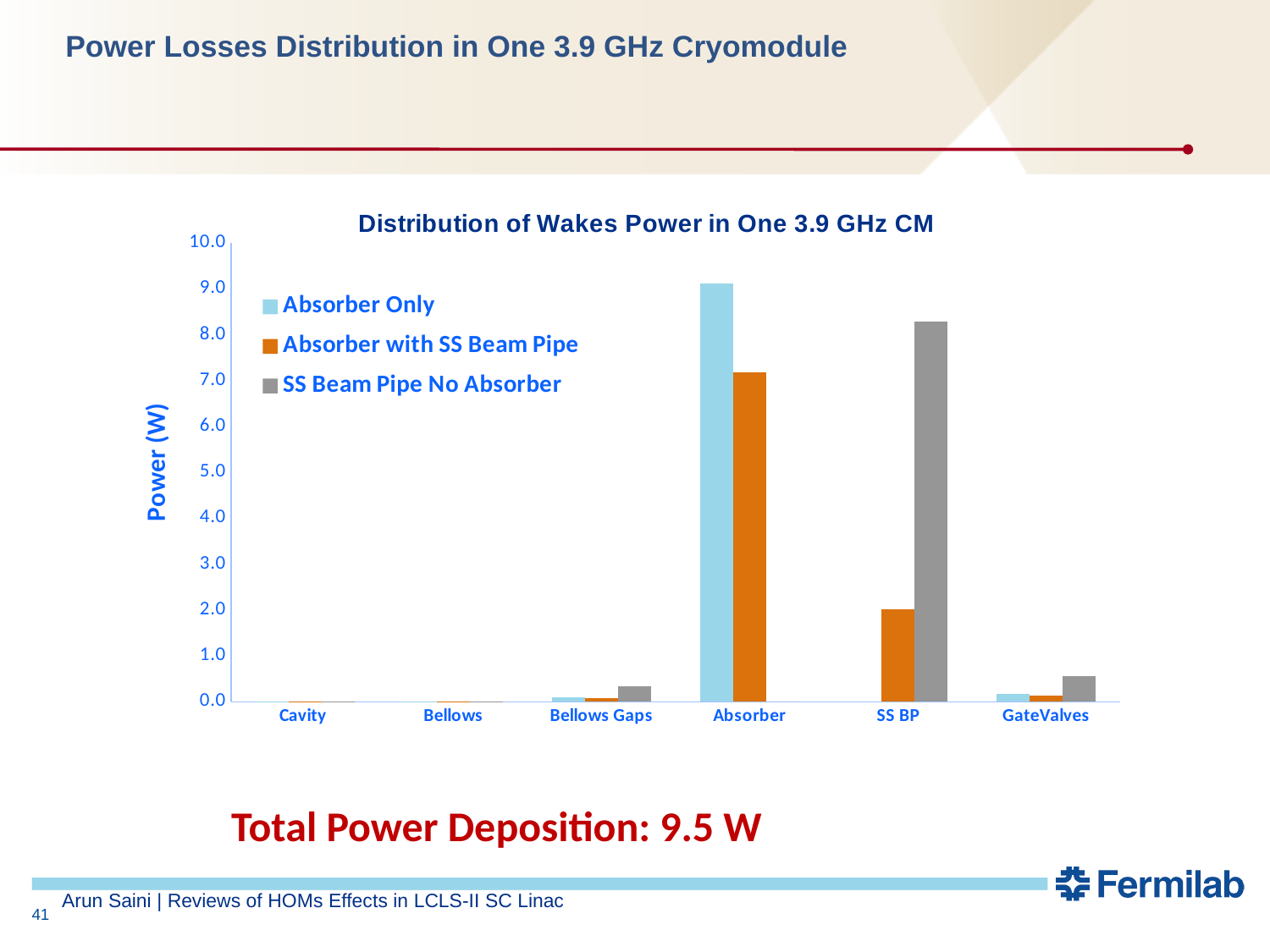
Is the Absorber with SS Beam Pipe value for Absorber greater or less than 6.0? greater Is the Absorber Only value for Absorber greater or less than 8.0? greater What is the label of the y axis? Power (W) At the Absorber category, which series has the larger value: Absorber Only or Absorber with SS Beam Pipe? Absorber Only What is the title of the chart? Distribution of Wakes Power in One 3.9 GHz CM Is the Absorber with SS Beam Pipe value for SS BP greater or less than 3.0? less How many categories are shown on the x axis? 6 For the Absorber Only series, which category has the highest value? Absorber What kind of chart is shown on the slide? bar chart For the SS Beam Pipe No Absorber series, which category has the highest value? SS BP How many series does the legend list? 3